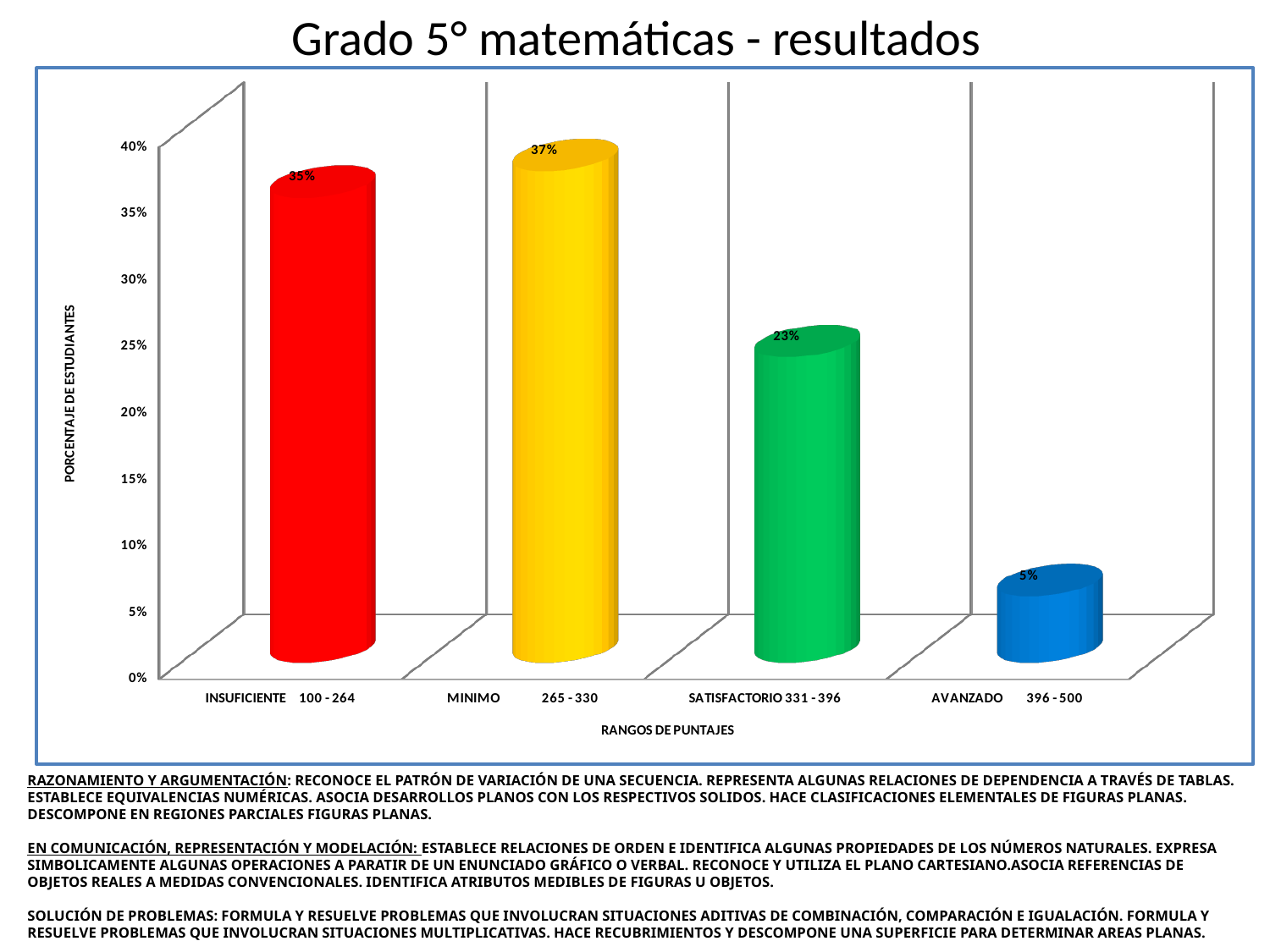
Which score range has the highest percentage of students? MINIMO 265 - 330 What percentage of students is shown for AVANZADO 396 - 500? 5% Which score range has the lowest percentage of students? AVANZADO 396 - 500 What percentage of students is shown for SATISFACTORIO 331 - 396? 23% What percentage of students is shown for MINIMO 265 - 330? 37% How many score ranges are shown on the x axis? 4 Which has a larger percentage of students, INSUFICIENTE 100 - 264 or SATISFACTORIO 331 - 396? INSUFICIENTE 100 - 264 What is the difference in percentage points between SATISFACTORIO 331 - 396 and AVANZADO 396 - 500? 18% What percentage of students is shown for INSUFICIENTE 100 - 264? 35% What kind of chart is shown on the slide? Bar chart What is the title of the chart? Grado 5° matemáticas - resultados What is the label of the vertical axis? PORCENTAJE DE ESTUDIANTES